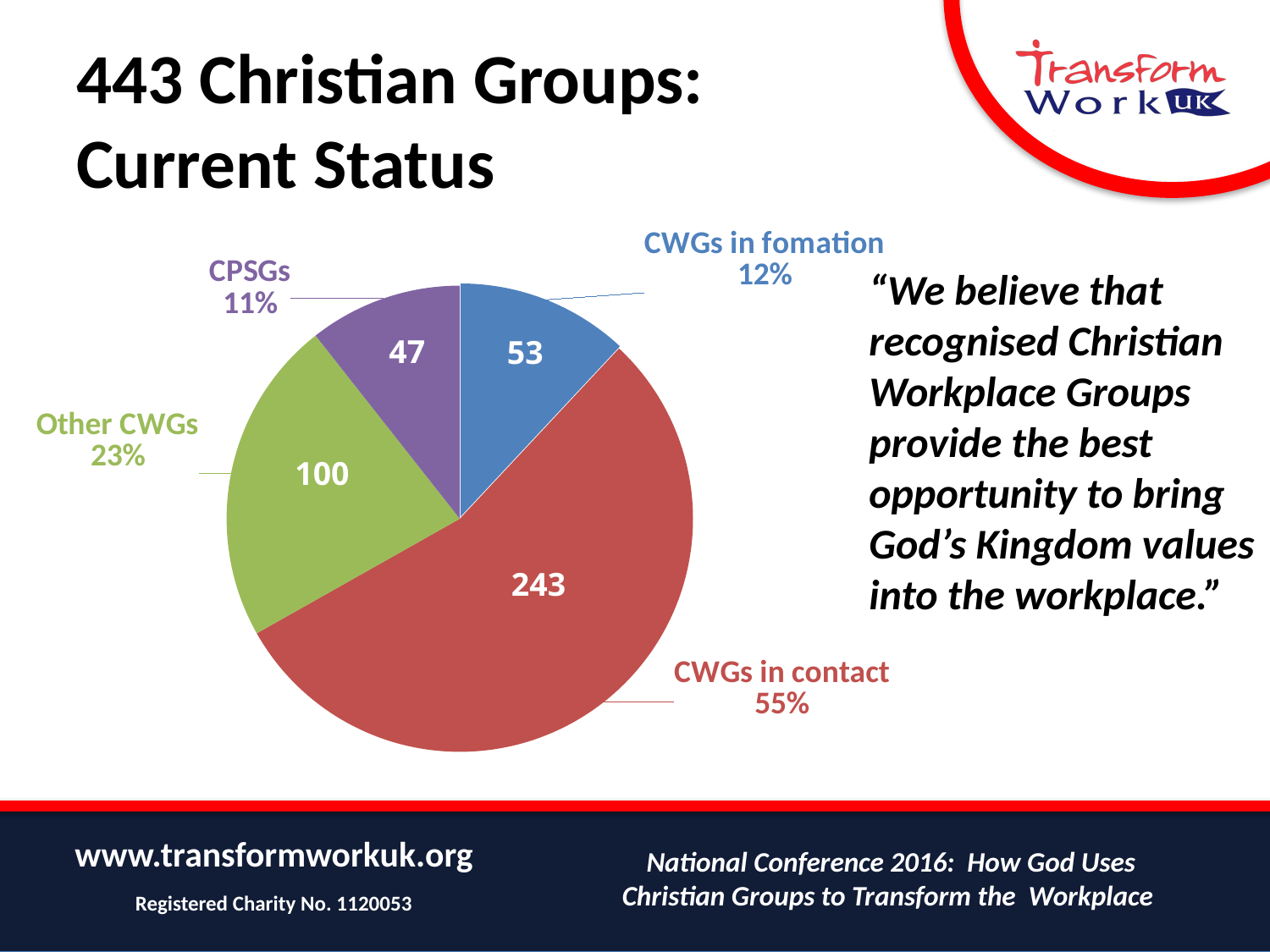
What is the difference between the CWGs in contact value and the Other CWGs value? 143 Which slice of the pie chart is the smallest? CPSGs What percentage share is shown for the CWGs in contact slice? 55% How many slices does the pie chart have? 4 Which slice of the pie chart is the largest? CWGs in contact What is the total of all four slice values in the pie chart? 443 What is the value shown for the CWGs in contact slice? 243 What is the value shown for the Other CWGs slice? 100 What percentage share is shown for the CWGs in fomation slice? 12% What kind of chart is shown on the slide? pie chart Which is larger, the value for CWGs in fomation or the value for CPSGs? CWGs in fomation What is the value shown for the CPSGs slice? 47